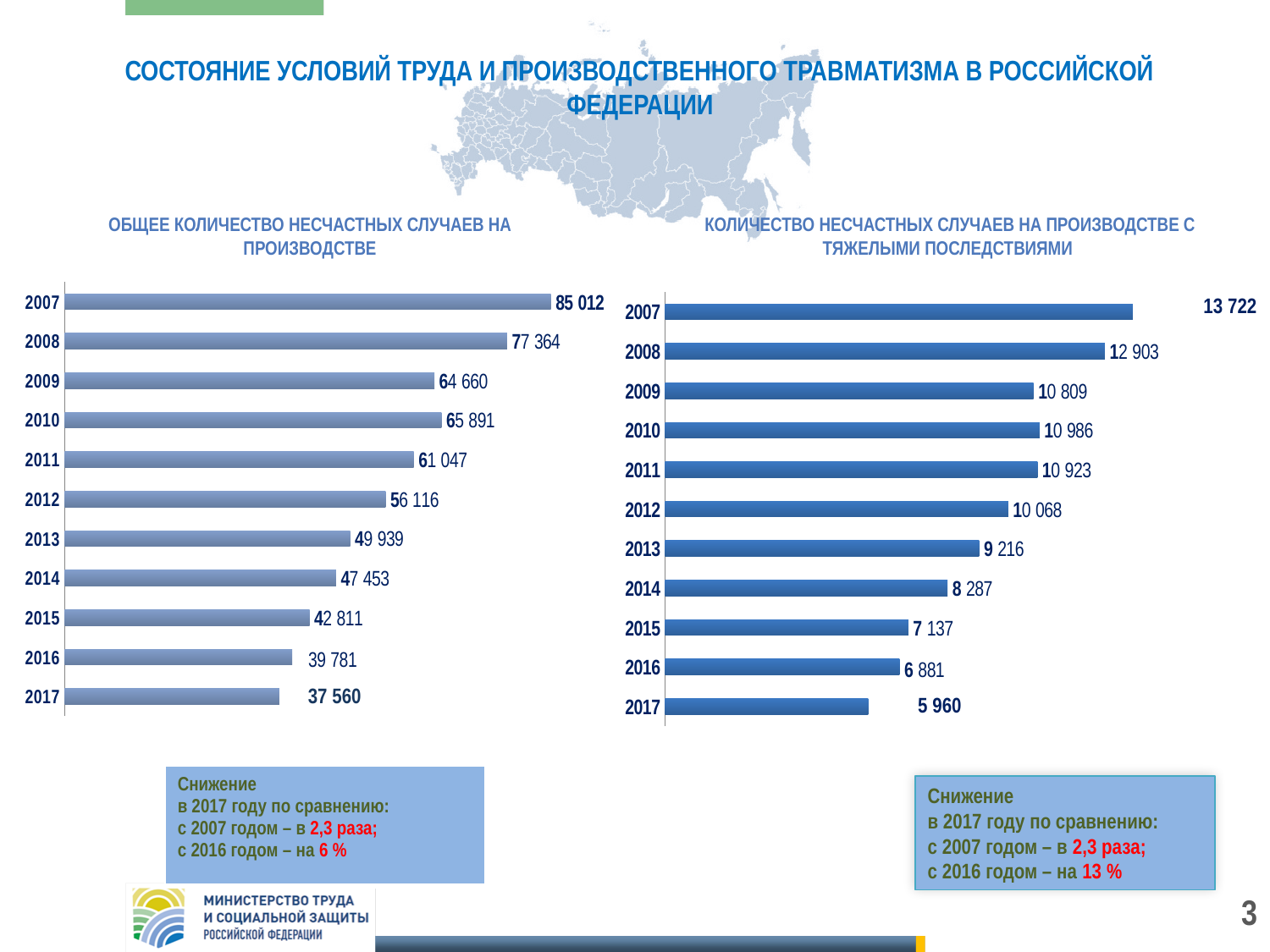
In the right chart (workplace accidents with severe consequences), which year has the lowest value? 2017 In the right chart (workplace accidents with severe consequences), what is the value for 2013? 9 216 In the right chart (workplace accidents with severe consequences), what is the difference between the 2007 and 2008 values? 819 In the left chart (total number of workplace accidents), what is the value for 2017? 37 560 In the right chart (workplace accidents with severe consequences), which is larger: the value for 2010 or the value for 2011? 2010 In the left chart (total number of workplace accidents), which is larger: the value for 2009 or the value for 2010? 2010 In the left chart (total number of workplace accidents), what is the difference between the 2016 and 2017 values? 2 221 What type of chart is used on the left side of the slide? Bar chart In the right chart (workplace accidents with severe consequences), do the values generally rise or fall from 2007 to 2017? Fall In the left chart (total number of workplace accidents), what is the value for 2007? 85 012 How many years are shown in the right chart (workplace accidents with severe consequences)? 11 In the left chart (total number of workplace accidents), which year has the highest value? 2007